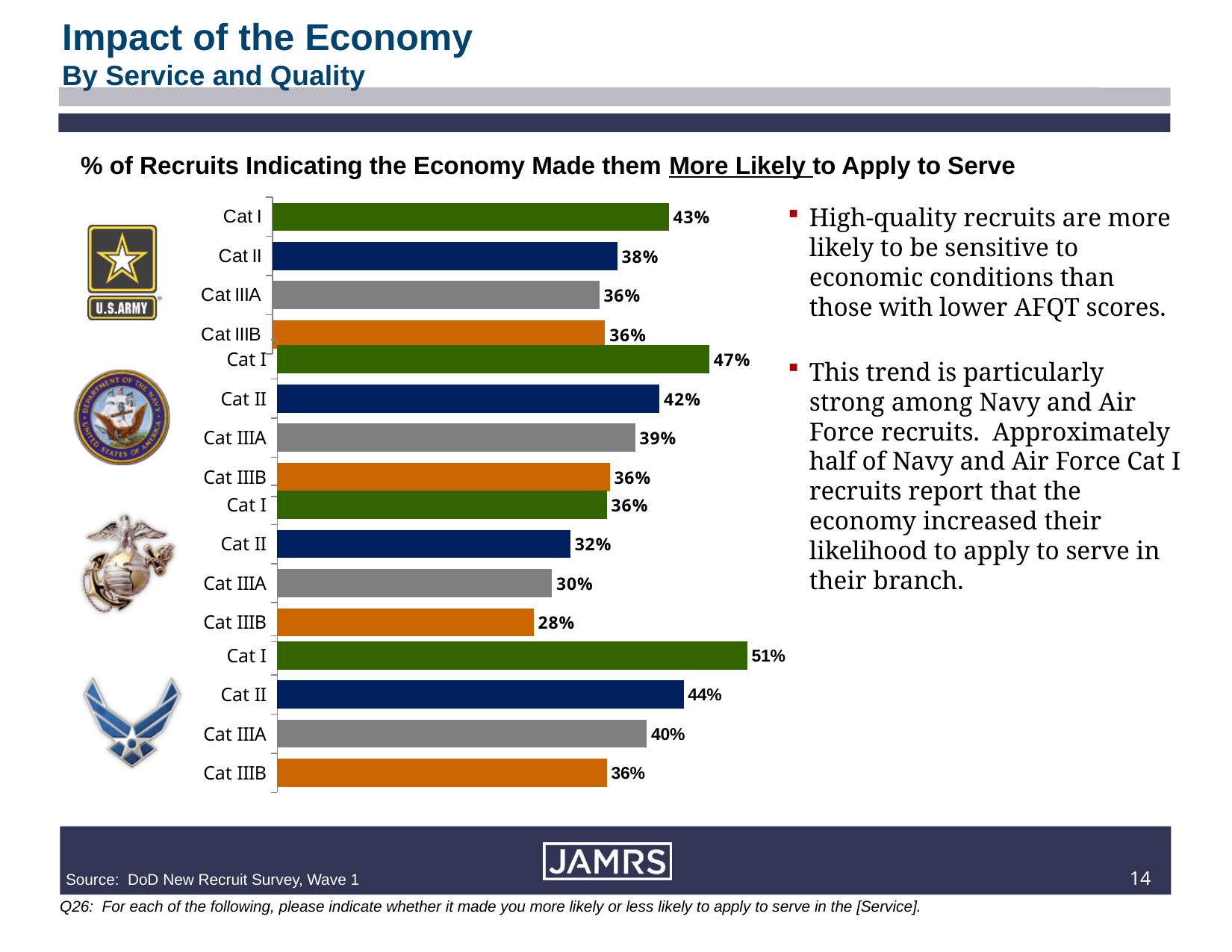
In the third chart from the top (next to the Marine Corps emblem), what is the value for Cat IIIB? 28% In the top chart (next to the U.S. Army logo), what is the value for Cat I? 43% In the second chart from the top (next to the Navy seal), do the values rise or fall going from Cat I down to Cat IIIB? Fall How many categories are plotted in the top chart (next to the U.S. Army logo)? 4 What kind of chart is used on this slide? Bar chart In the second chart from the top (next to the Navy seal), what is the value for Cat II? 42% In the bottom chart (next to the Air Force logo), what is the difference between the Cat I and Cat IIIB values? 15 percentage points In the bottom chart (next to the Air Force logo), which category has the highest value? Cat I In the third chart from the top (next to the Marine Corps emblem), which category has the lowest value? Cat IIIB In the bottom chart (next to the Air Force logo), what is the value for Cat IIIA? 40% What colour are the Cat IIIB bars in the charts? Orange In the second chart from the top (next to the Navy seal), which is larger, the value for Cat I or the value for Cat IIIA? Cat I